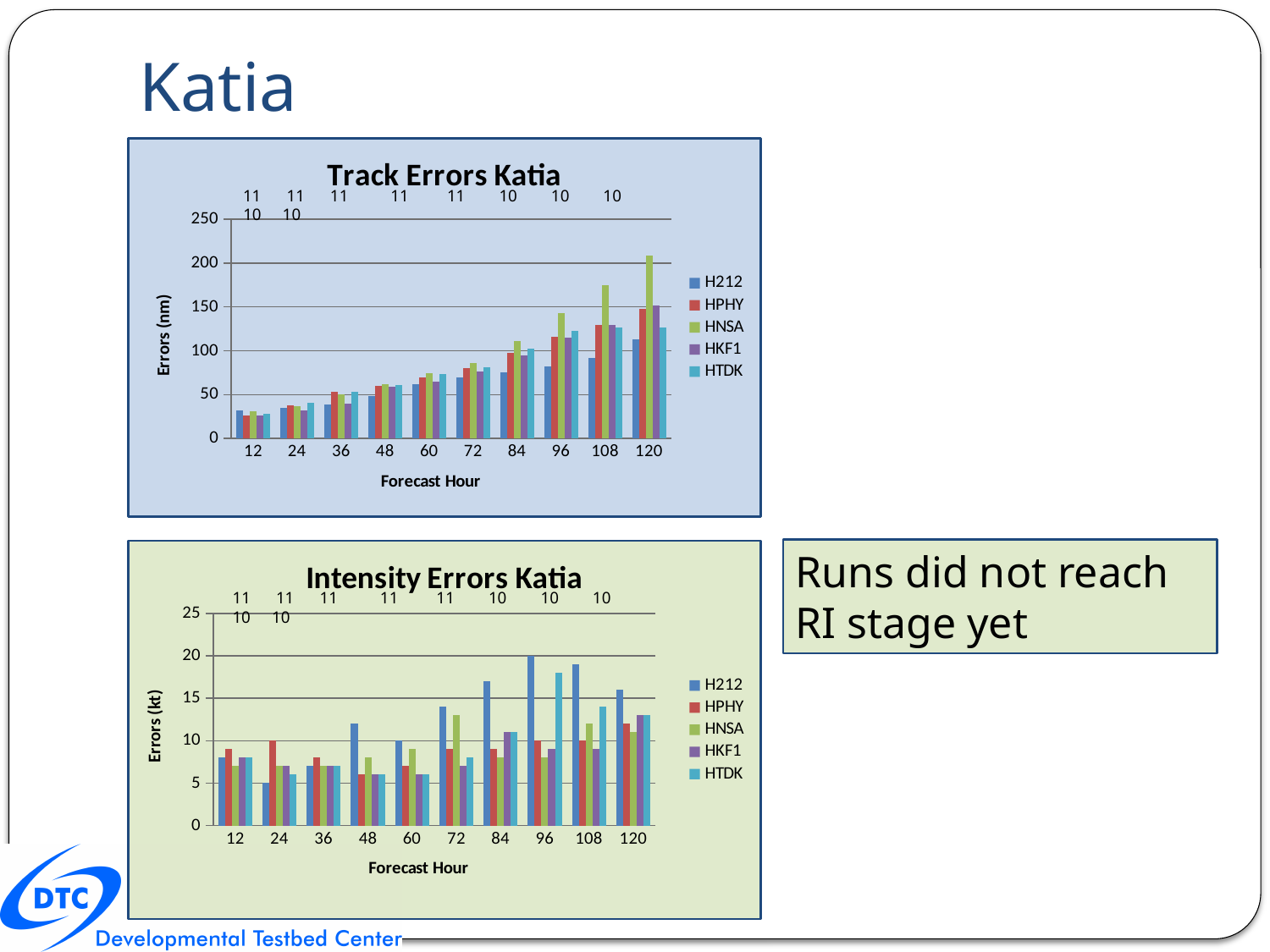
How many forecast hours are shown on the x axis of the Track Errors Katia chart? 10 In the Track Errors Katia chart, do the errors generally rise or fall as the forecast hour increases? rise How many series does the legend of the Intensity Errors Katia chart list? 5 In the Intensity Errors Katia chart, is the H212 value at forecast hour 96 greater or less than 15? greater What is the y-axis label of the Intensity Errors Katia chart? Errors (kt) In the Track Errors Katia chart, which series has the highest error at forecast hour 120? HNSA In the Track Errors Katia chart, is the HNSA value at forecast hour 120 greater or less than 200? greater In the Track Errors Katia chart, which is larger at forecast hour 120: HNSA or H212? HNSA What kind of chart is the Track Errors Katia chart? bar chart In the Track Errors Katia chart, is the H212 value at forecast hour 12 greater or less than 50? less In the Intensity Errors Katia chart, which is larger at forecast hour 48: H212 or HPHY? H212 In the Intensity Errors Katia chart, which series has the highest error at forecast hour 84? H212